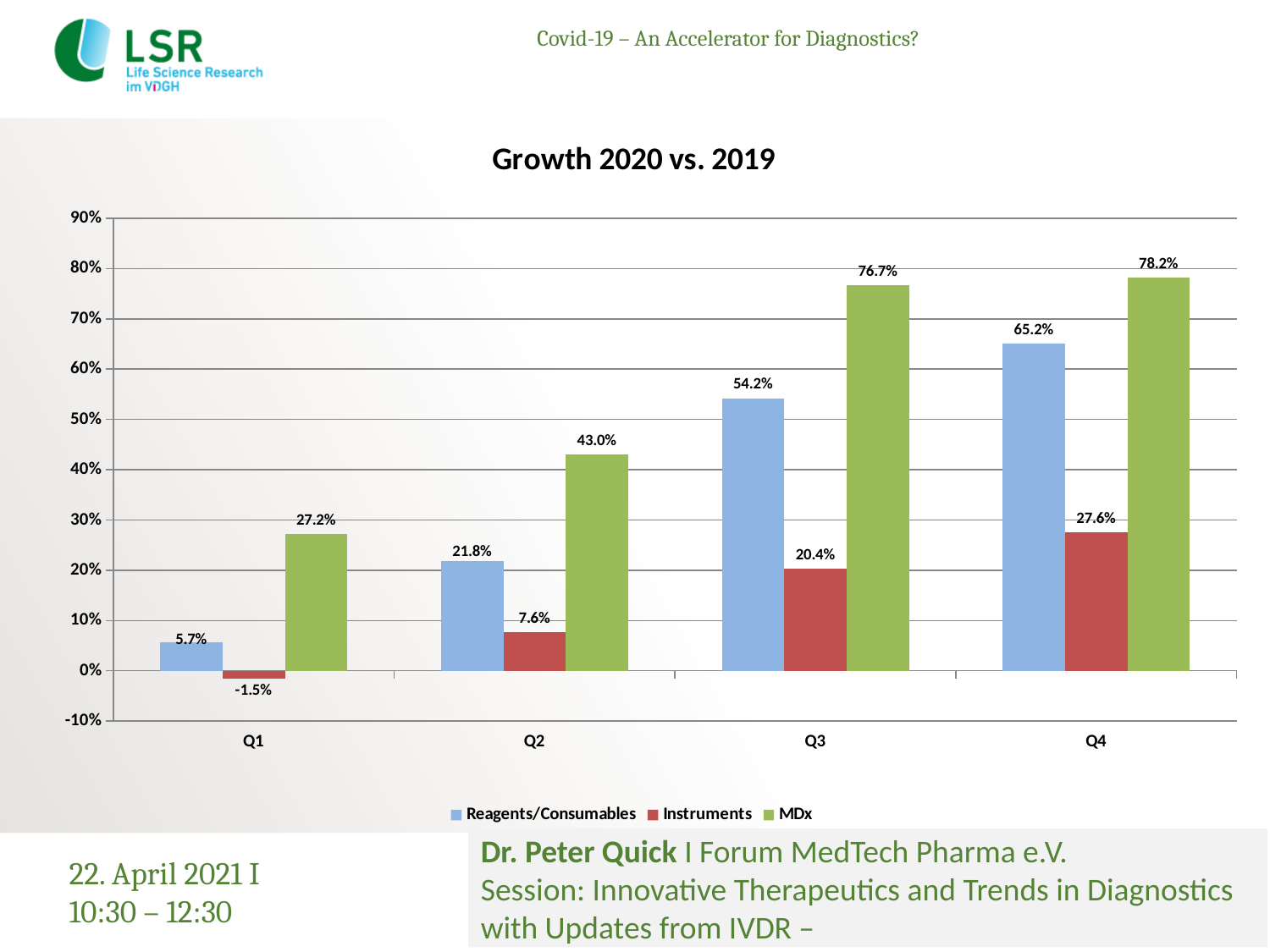
In which quarter is the Instruments growth lowest? Q1 How many series does the legend list? 3 Does the Reagents/Consumables growth rise or fall from Q1 to Q4? rise What is the growth value for Reagents/Consumables in Q4? 65.2% What is the difference between the MDx and Reagents/Consumables growth values in Q2? 21.2% How many quarters are shown on the x axis? 4 Which is larger in Q3: the Reagents/Consumables growth or the Instruments growth? Reagents/Consumables Is the Reagents/Consumables growth in Q3 greater or less than 50%? greater What kind of chart is shown on the slide? bar chart What is the growth value for MDx in Q3? 76.7% In which quarter is the MDx growth highest? Q4 What is the growth value for Instruments in Q1? -1.5%